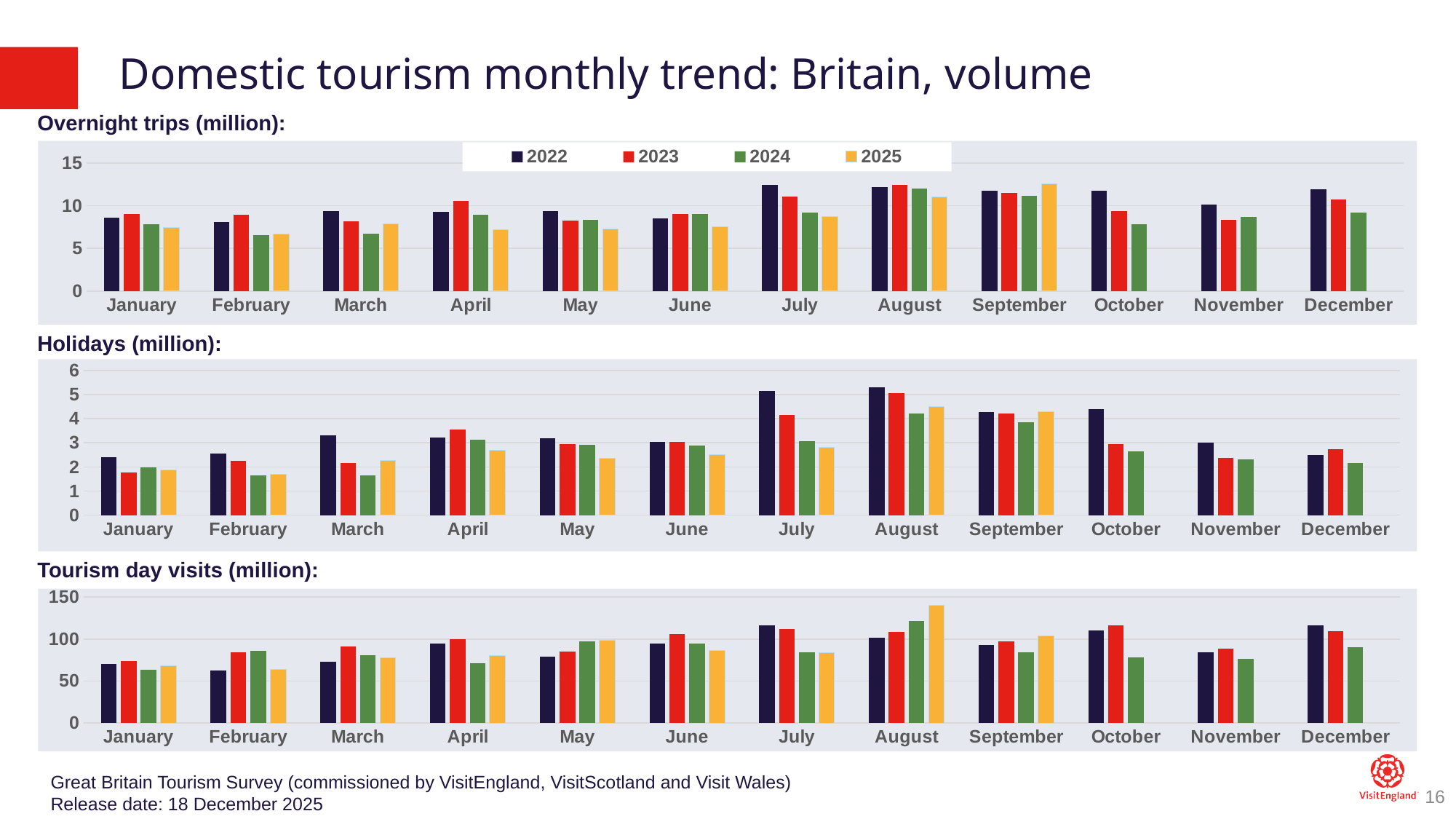
In the 'Tourism day visits (million)' chart, is the value for August 2025 greater or less than 100? greater In the 'Overnight trips (million)' chart, which is larger for July: 2022 or 2024? 2022 In the 'Holidays (million)' chart, is the value for February 2024 greater or less than 2? less How many months are shown on the x axis of the 'Holidays (million)' chart? 12 In the 'Holidays (million)' chart, is the value for August 2022 greater or less than 4? greater In the 'Holidays (million)' chart, which is larger for 2022: January or August? August What kind of chart is the 'Overnight trips (million)' chart? bar chart How many series does the legend of the 'Overnight trips (million)' chart list? 4 In the 'Tourism day visits (million)' chart, which year has the highest bar for August? 2025